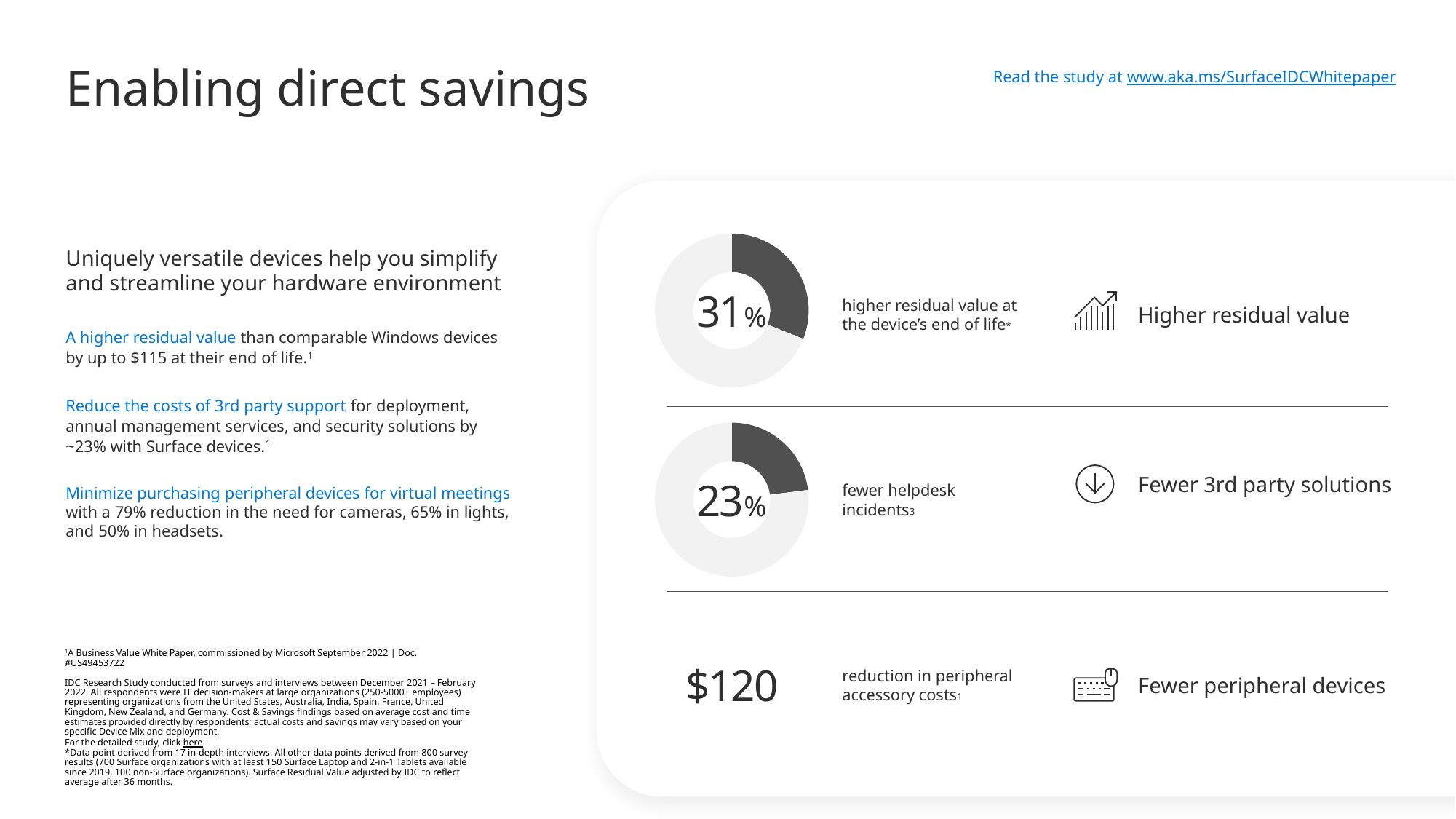
What kind of chart is used to show the 31% higher residual value figure? Donut (pie) chart In the middle donut chart, is the highlighted share greater or less than 50%? less What share of the top donut chart is filled with the dark segment? 31% In the top donut chart, is the highlighted share greater or less than 25%? greater What share of the middle donut chart is filled with the dark segment? 23% What is the difference between the percentage in the top donut chart and the percentage in the middle donut chart? 8 percentage points What label accompanies the middle donut chart showing 23%? fewer helpdesk incidents How many donut charts are shown on the slide? 2 What colour is the highlighted segment in the donut charts? Dark grey What value is shown in the middle donut chart next to 'fewer helpdesk incidents'? 23% What value is shown in the top donut chart next to 'higher residual value at the device's end of life'? 31% Which donut chart shows the larger highlighted share: the top one (higher residual value) or the middle one (fewer helpdesk incidents)? The top one (higher residual value)